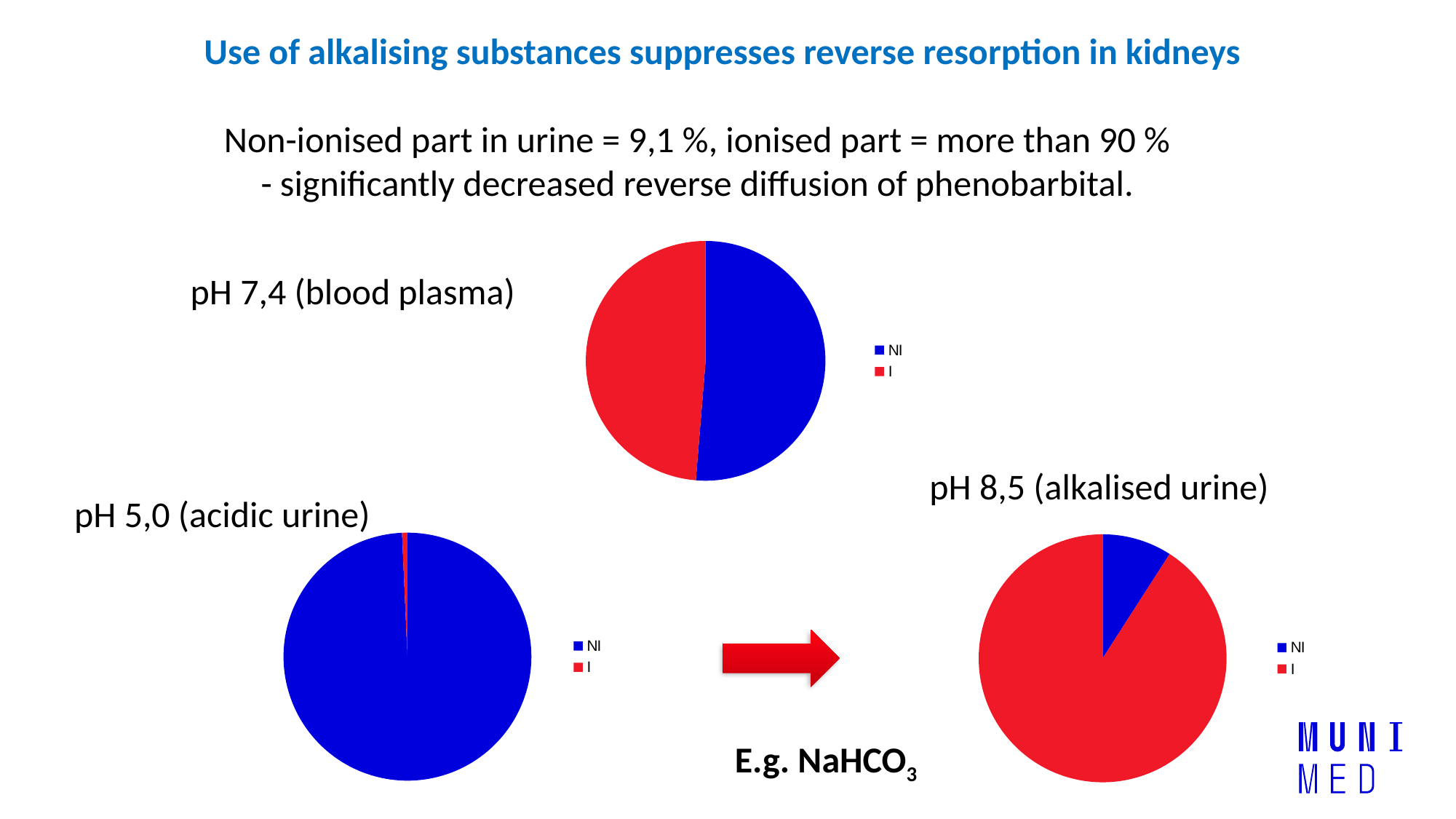
How many pie charts are shown on the slide? 3 In the pH 8,5 (alkalised urine) chart, is the I slice larger or smaller than the NI slice? larger In the pH 8,5 (alkalised urine) chart, which slice is the smallest? NI How many series does the legend of the pH 8,5 (alkalised urine) chart list? 2 What are the two legend entries of the pH 5,0 (acidic urine) chart? NI and I What kind of chart is used for the pH 5,0 (acidic urine) chart? pie chart In the pH 8,5 (alkalised urine) chart, which slice is the largest? I How many slices does the pH 7,4 (blood plasma) pie chart have? 2 In the pH 5,0 (acidic urine) chart, which slice is the smallest? I In the pH 5,0 (acidic urine) chart, which slice is the largest? NI In the pH 7,4 (blood plasma) chart, what colour represents the I series? red Is the NI slice larger in the pH 5,0 (acidic urine) chart or in the pH 8,5 (alkalised urine) chart? pH 5,0 (acidic urine)